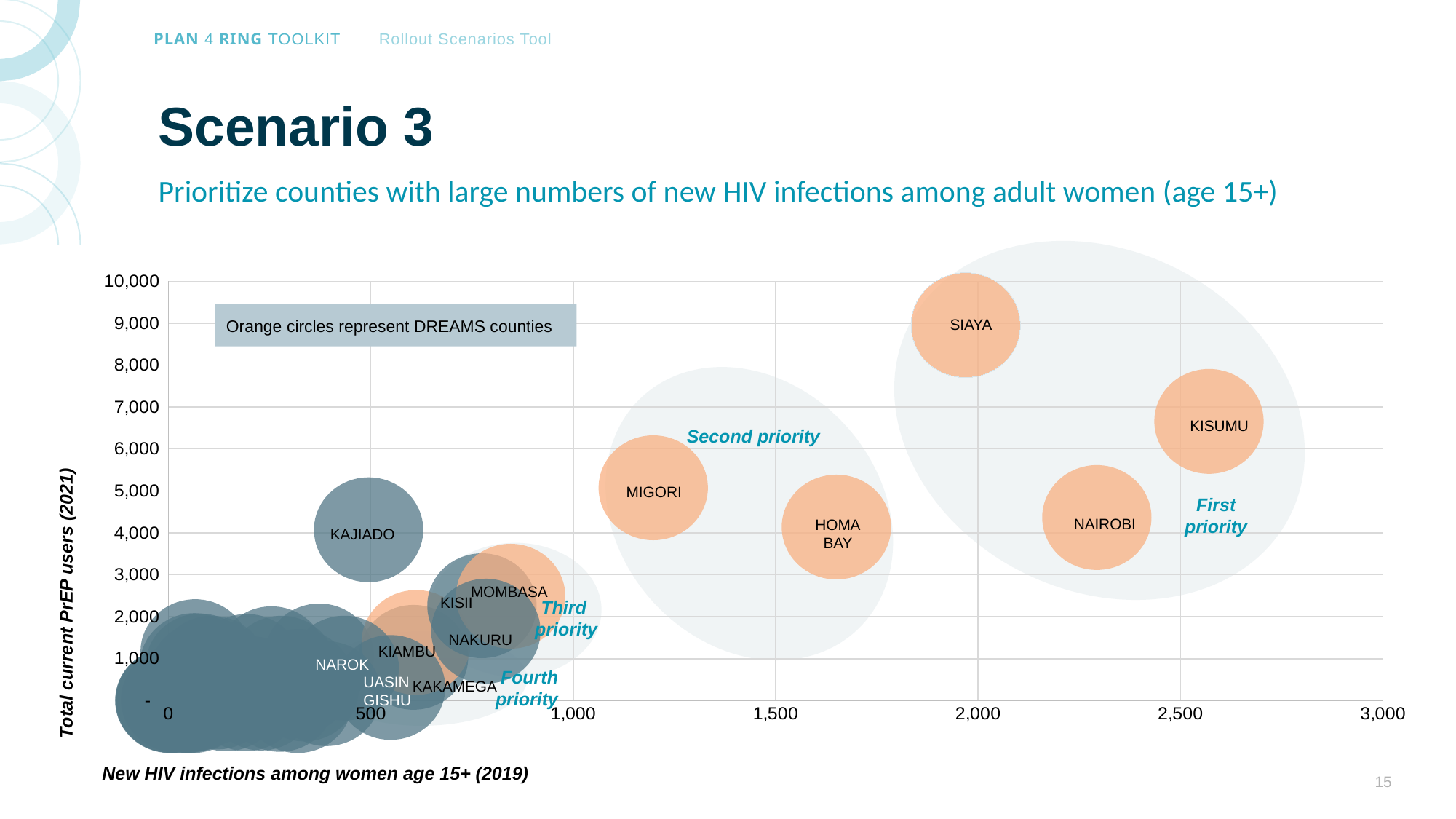
According to the note on the chart, what do the orange circles represent? DREAMS counties What is the label of the x axis of the chart? New HIV infections among women age 15+ (2019) Which county has the highest total current PrEP users (2021)? SIAYA Which county has more total current PrEP users, MIGORI or HOMA BAY? MIGORI Is the total current PrEP users value for KAJIADO greater or less than 3,000? greater What kind of chart is shown on the slide? bubble chart Which county has the largest number of new HIV infections among women age 15+ (2019)? KISUMU Is the number of new HIV infections for MIGORI greater or less than 1,500? less Is the total current PrEP users value for NAIROBI greater or less than 5,000? less Which county has more new HIV infections among women age 15+, NAIROBI or HOMA BAY? NAIROBI